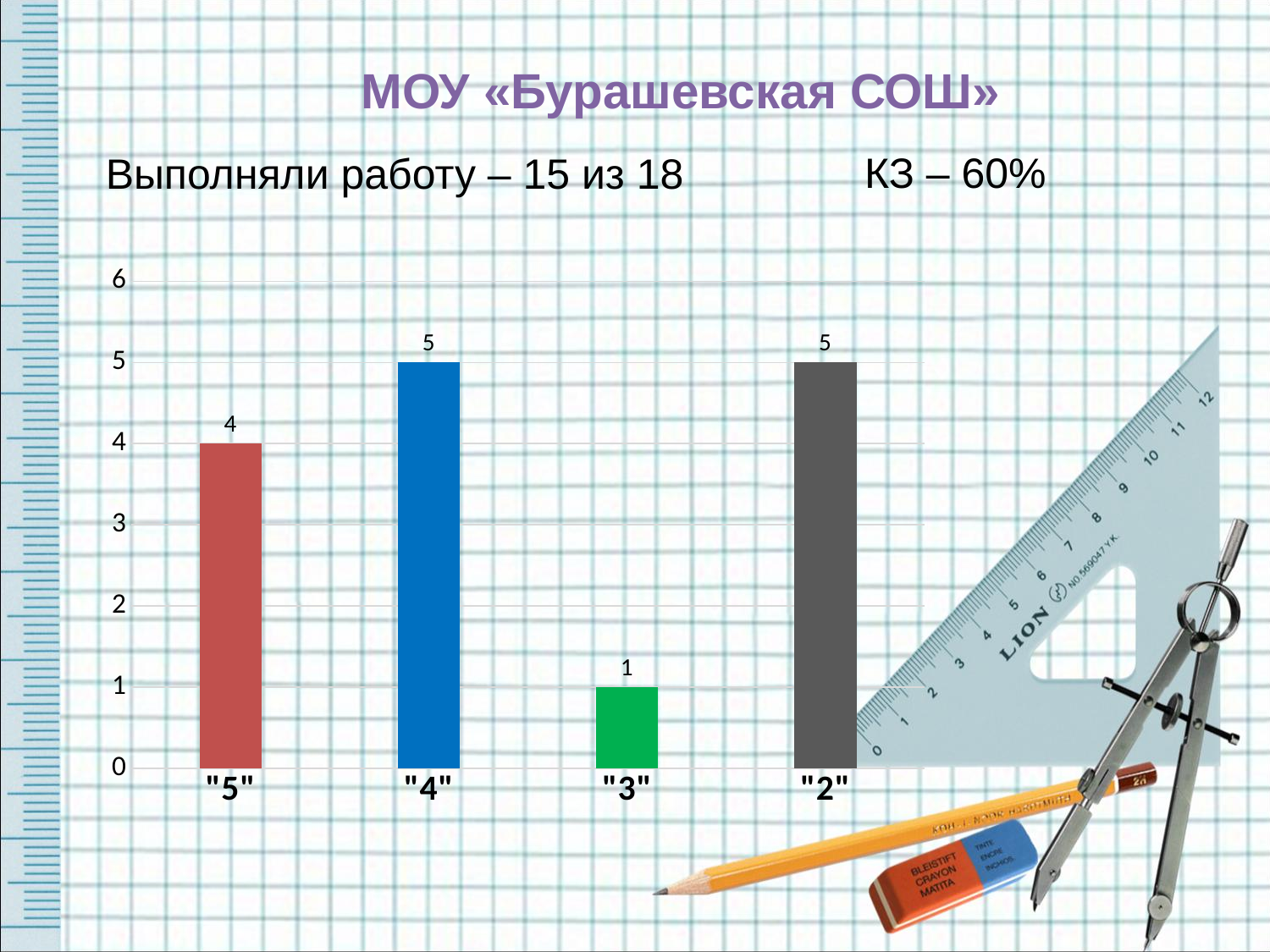
Which category has the lowest value? "3" What is the value for the "3" category? 1 Which is larger, the value for "5" or the value for "3"? "5" What is the value for the "5" category? 4 What is the difference between the values for "5" and "3"? 3 What kind of chart is shown on the slide? bar chart What is the value for the "4" category? 5 What is the difference between the values for "4" and "3"? 4 How many categories are shown on the chart? 4 Which is larger, the value for "5" or the value for "4"? "4" What colour is the bar for the "3" category? green What is the value for the "2" category? 5